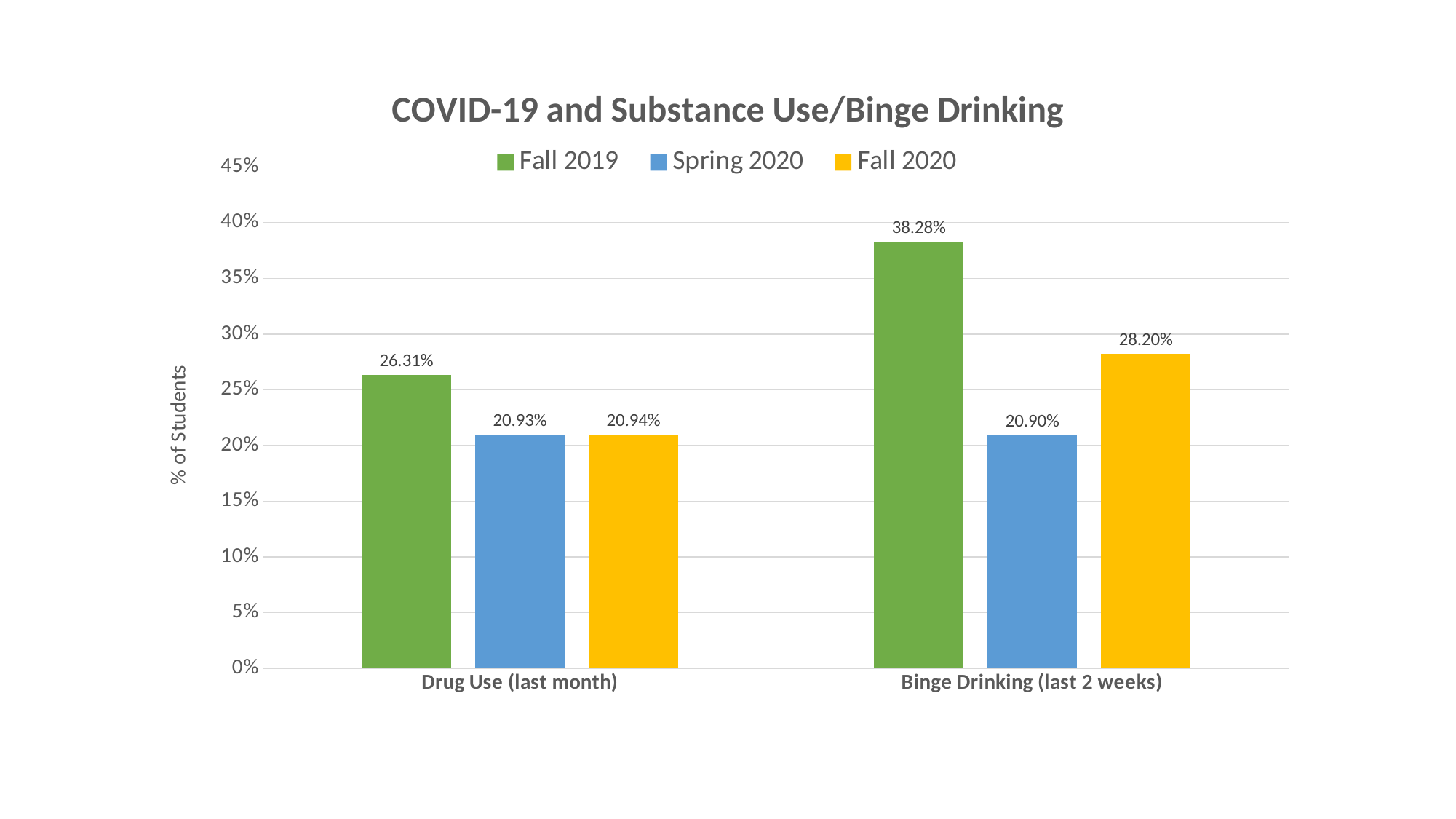
What is the Spring 2020 value for Binge Drinking (last 2 weeks)? 20.90% Which is larger: the Fall 2019 value for Drug Use (last month) or the Fall 2019 value for Binge Drinking (last 2 weeks)? Binge Drinking (last 2 weeks) What is the difference between the Fall 2019 and Spring 2020 values for Drug Use (last month)? 5.38% What kind of chart is shown on the slide? Bar chart What is the Fall 2019 value for Drug Use (last month)? 26.31% What is the Fall 2020 value for Binge Drinking (last 2 weeks)? 28.20% What is the Fall 2020 value for Drug Use (last month)? 20.94% Which series has the highest value for Binge Drinking (last 2 weeks)? Fall 2019 What is the difference between the Fall 2019 and Fall 2020 values for Binge Drinking (last 2 weeks)? 10.08% What is the title of the chart? COVID-19 and Substance Use/Binge Drinking Which series has the lowest value for Binge Drinking (last 2 weeks)? Spring 2020 How many series does the legend list? 3